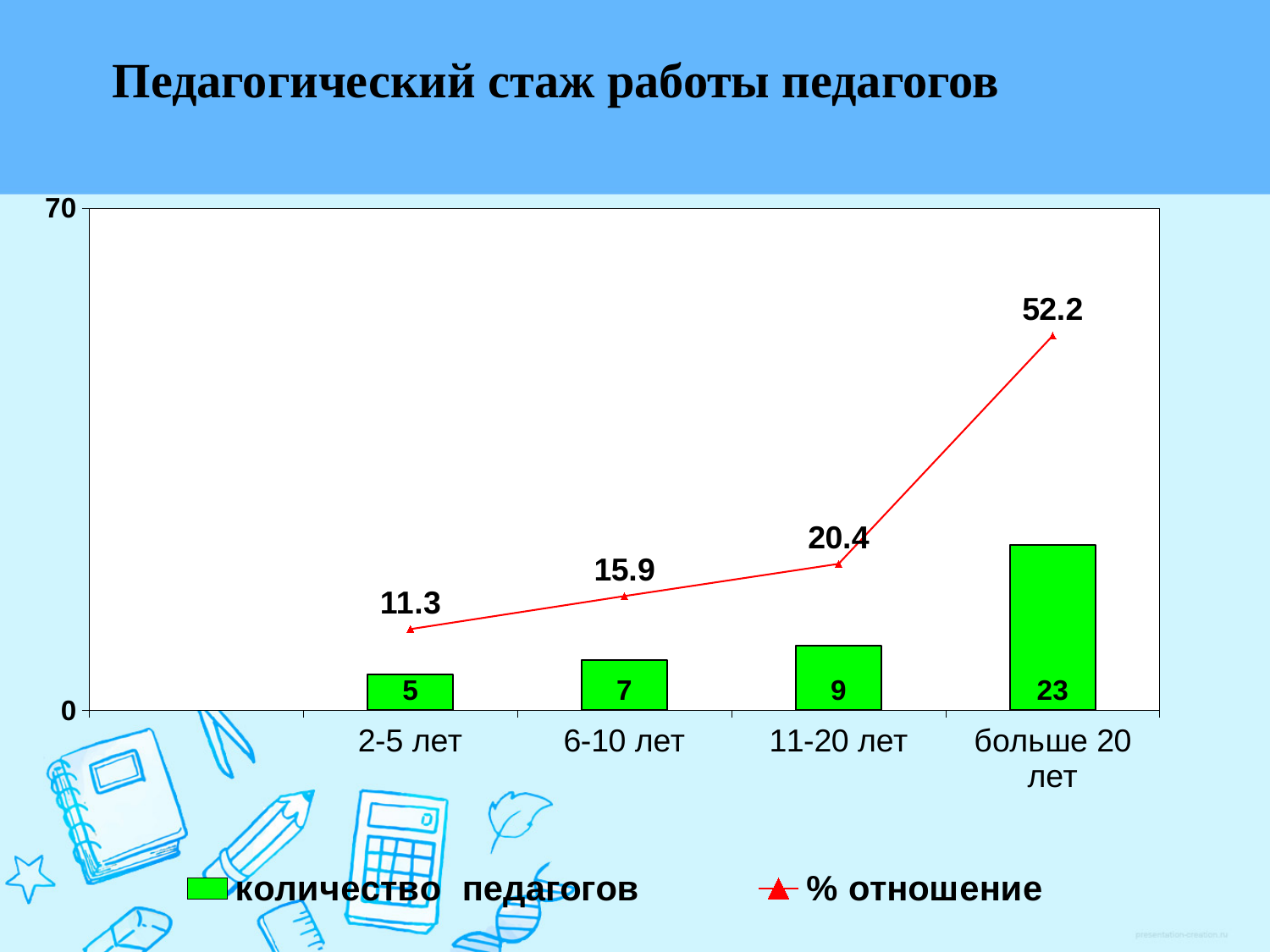
What is the value of '% отношение' for the '6-10 лет' category? 15.9 What is the title of the chart? Педагогический стаж работы педагогов Do the '% отношение' values rise or fall from left to right along the x axis? rise Which is larger: the '% отношение' value for '11-20 лет' or for '6-10 лет'? 11-20 лет How many categories are shown on the x axis? 4 How many series does the legend list? 2 Which category has the highest value of 'количество педагогов'? больше 20 лет What is the value of 'количество педагогов' for the '11-20 лет' category? 9 What is the value of 'количество педагогов' for the '2-5 лет' category? 5 What is the difference in 'количество педагогов' between 'больше 20 лет' and '11-20 лет'? 14 What is the value of '% отношение' for the 'больше 20 лет' category? 52.2 Which category has the lowest value of '% отношение'? 2-5 лет